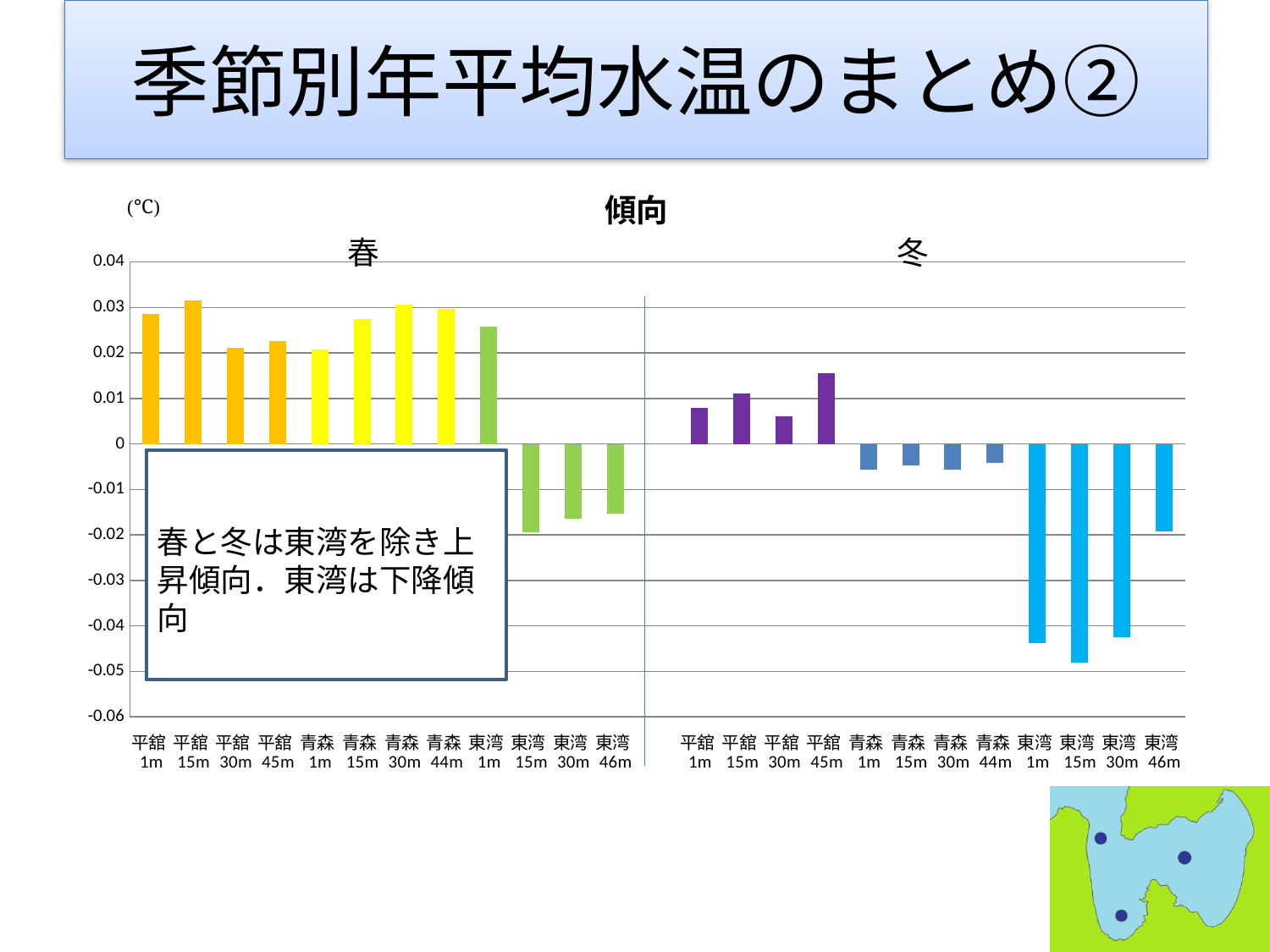
In the 春 section, which is larger, the value for 平舘 1m or the value for 平舘 30m? 平舘 1m Which category has the lowest value in the whole chart? 冬 東湾 15m How many bars are plotted in total across both the 春 and 冬 sections? 24 What is the title of the chart? 傾向 In the 冬 section, is the value for 東湾 15m greater or less than -0.04? less In the 春 section, is the value for 平舘 1m greater or less than 0.02? greater How many bars are plotted in the 春 (spring) section of the chart? 12 What unit is shown on the vertical axis of the chart? ℃ In the 冬 section, which category has the highest value? 平舘 45m What kind of chart is shown on the slide? bar chart In the 冬 section, is the value for 平舘 45m greater or less than 0.01? greater